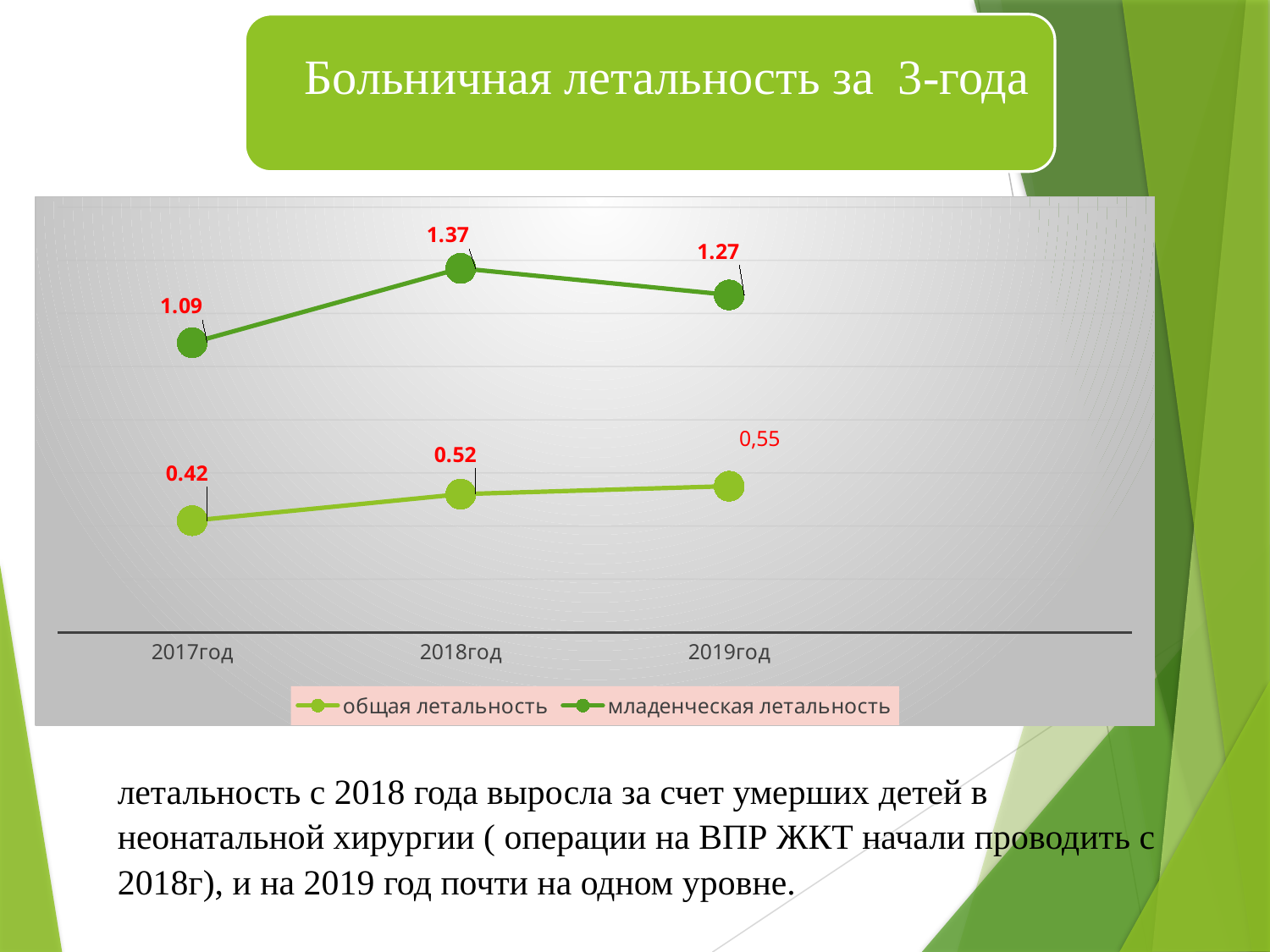
How many series does the legend list? 2 What is the value of младенческая летальность in 2019год? 1.27 What is the value of общая летальность in 2019год? 0,55 Does общая летальность rise or fall from 2017год to 2019год? rise In which year is младенческая летальность highest? 2018год How many years are shown on the x axis? 3 What is the value of младенческая летальность in 2018год? 1.37 What is the difference between младенческая летальность in 2018год and 2017год? 0.28 In which year is общая летальность lowest? 2017год What is the value of общая летальность in 2017год? 0.42 Which is larger: младенческая летальность in 2017год or общая летальность in 2018год? младенческая летальность in 2017год What type of chart is shown on the slide? line chart